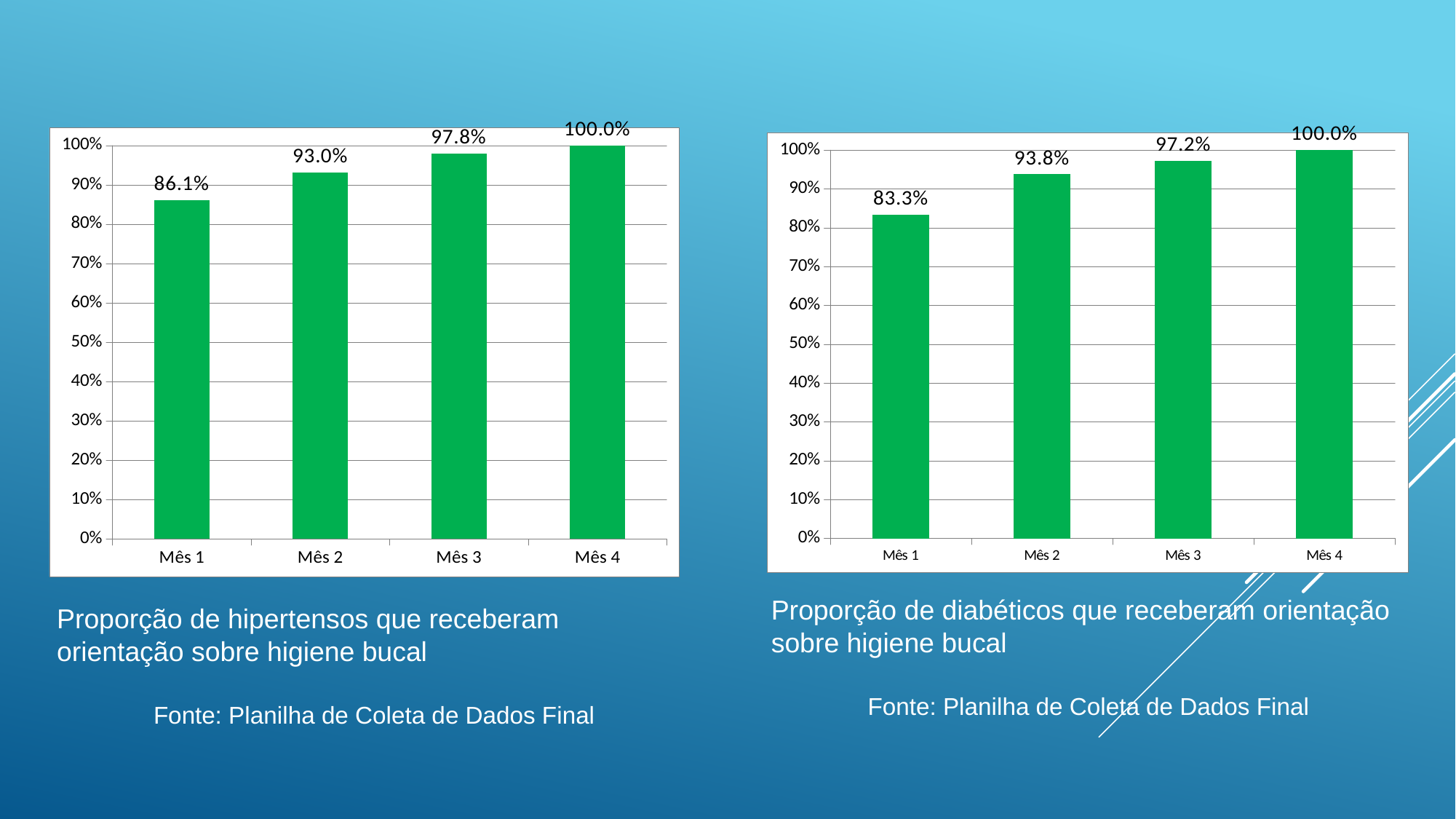
In the left chart (hipertensos), which month has the highest value? Mês 4 What kind of chart is the right chart (diabéticos)? bar chart In the left chart (hipertensos), what is the value for Mês 1? 86.1% How many months are shown in the left chart (hipertensos)? 4 In the right chart (diabéticos), do the values rise or fall from Mês 1 to Mês 4? rise In the left chart (hipertensos), what is the value for Mês 3? 97.8% In the right chart (diabéticos), what is the difference between Mês 3 and Mês 1? 13.9% In the left chart (hipertensos), what is the difference between Mês 4 and Mês 1? 13.9% In the right chart (diabéticos), which month has the lowest value? Mês 1 In the right chart (diabéticos), is the value for Mês 1 greater or less than 90%? less Which is larger: Mês 2 in the left chart (hipertensos) or Mês 2 in the right chart (diabéticos)? Mês 2 in the right chart (diabéticos) In the right chart (diabéticos), what is the value for Mês 2? 93.8%